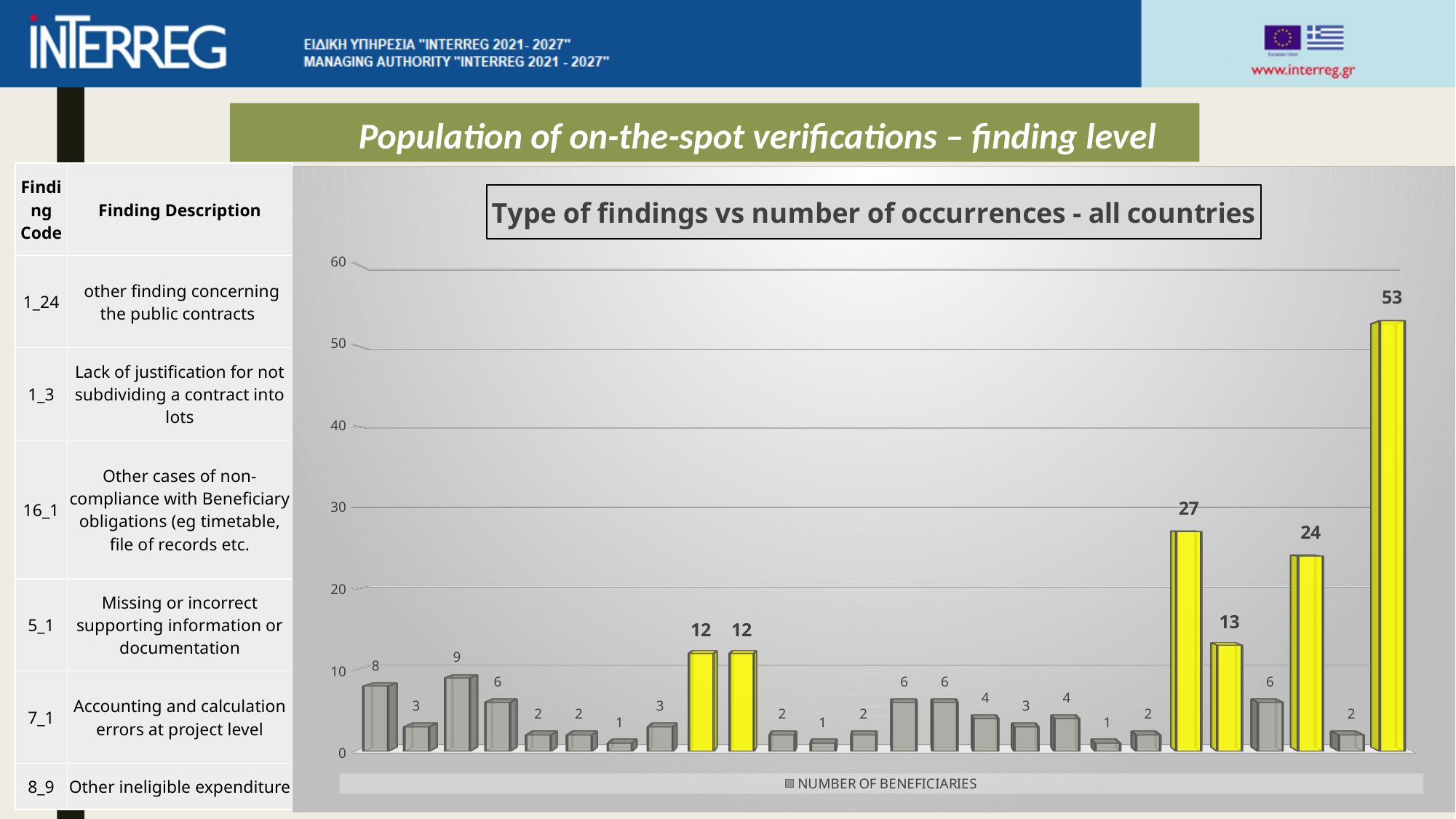
How many series does the legend list? 1 What is the lowest value shown by any bar in the chart? 1 What is the difference between the rightmost bar (53) and the leftmost bar (8)? 45 What is the highest value shown by any bar in the chart? 53 What is the title of the chart? Type of findings vs number of occurrences - all countries What kind of chart is shown on the slide? bar chart What is the value of the leftmost bar in the chart? 8 How many bars are plotted in the chart? 26 What is the single legend entry shown below the chart? NUMBER OF BENEFICIARIES Which is larger, the rightmost bar or the leftmost bar? the rightmost bar Is the value of the tallest bar greater or less than 50? greater What is the value of the rightmost bar in the chart? 53